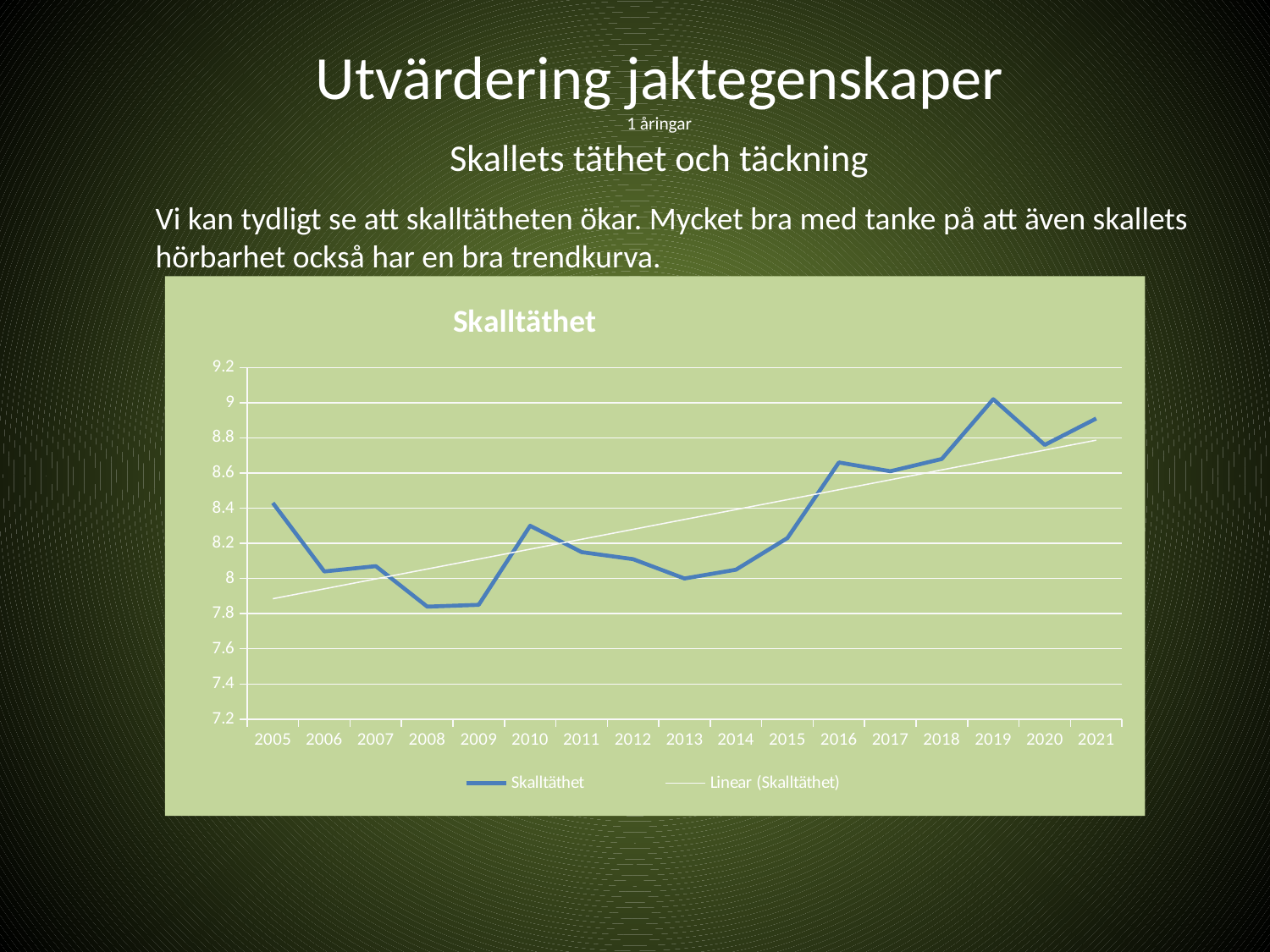
Is the Skalltäthet value for 2008 greater or less than 8? less Which year has the larger Skalltäthet value, 2010 or 2013? 2010 How many years are plotted along the x axis of the chart? 17 How many entries does the chart legend list? 2 Which year has the larger Skalltäthet value, 2005 or 2006? 2005 Is the Skalltäthet value for 2019 greater or less than 8.8? greater Which year has the highest Skalltäthet value? 2019 What is the title of the chart? Skalltäthet Is the Skalltäthet value for 2005 greater or less than 8.2? greater What kind of chart is shown on the slide? line chart Does the Skalltäthet trendline rise or fall from 2005 to 2021? rises